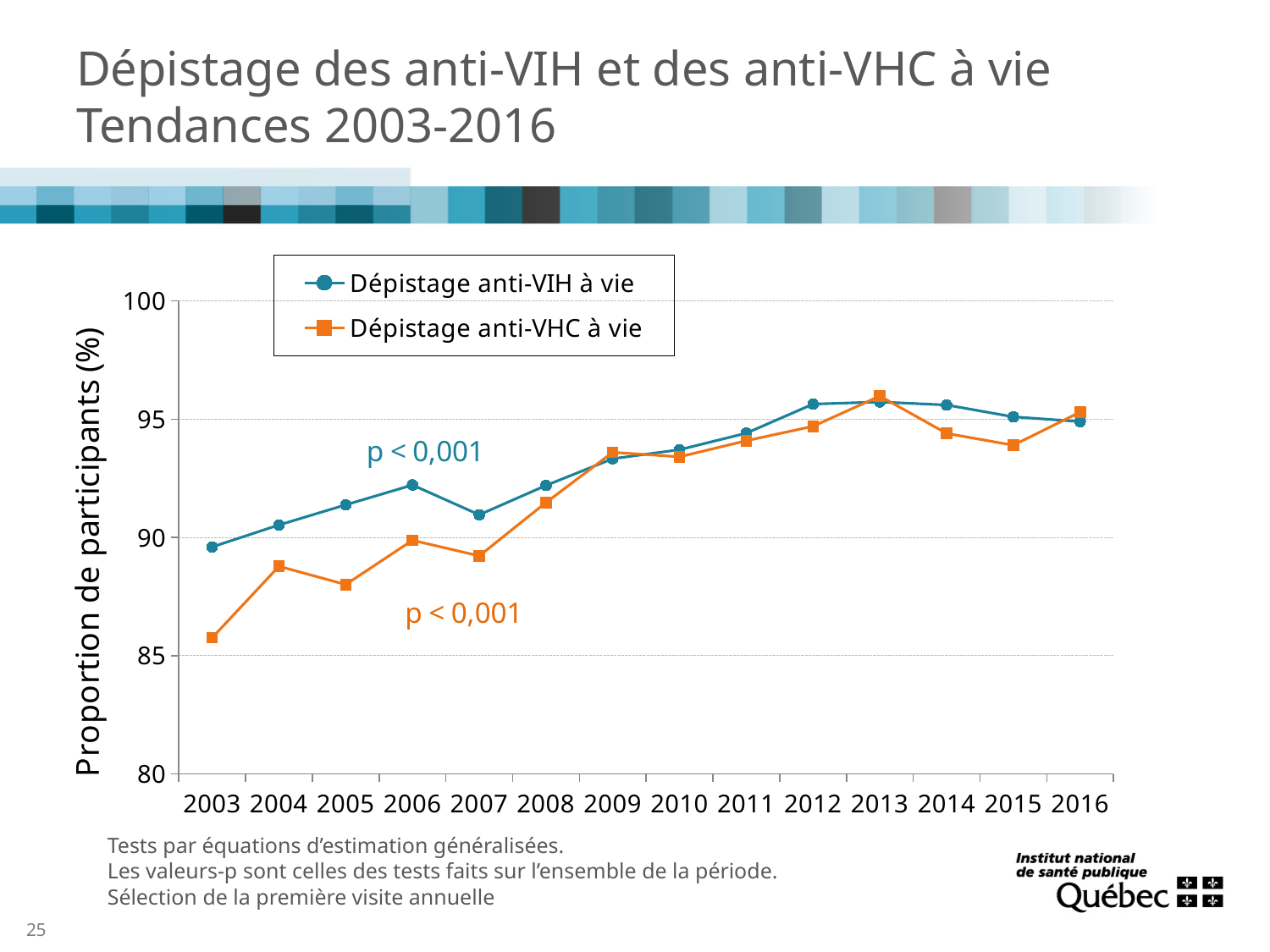
In which year is the value for Dépistage anti-VHC à vie lowest? 2003 What kind of chart is shown on the slide? line chart Is the value for Dépistage anti-VHC à vie in 2013 greater or less than 95? greater Overall, does the Dépistage anti-VHC à vie series rise or fall from 2003 to 2016? rise In 2003, which series has the higher value, Dépistage anti-VIH à vie or Dépistage anti-VHC à vie? Dépistage anti-VIH à vie Is the value for Dépistage anti-VHC à vie in 2005 greater or less than 90? less How many series does the legend list? 2 Is the value for Dépistage anti-VIH à vie in 2012 greater or less than 95? greater How many years are plotted along the x axis? 14 In 2006, which series has the higher value, Dépistage anti-VIH à vie or Dépistage anti-VHC à vie? Dépistage anti-VIH à vie In which year is the value for Dépistage anti-VHC à vie highest? 2013